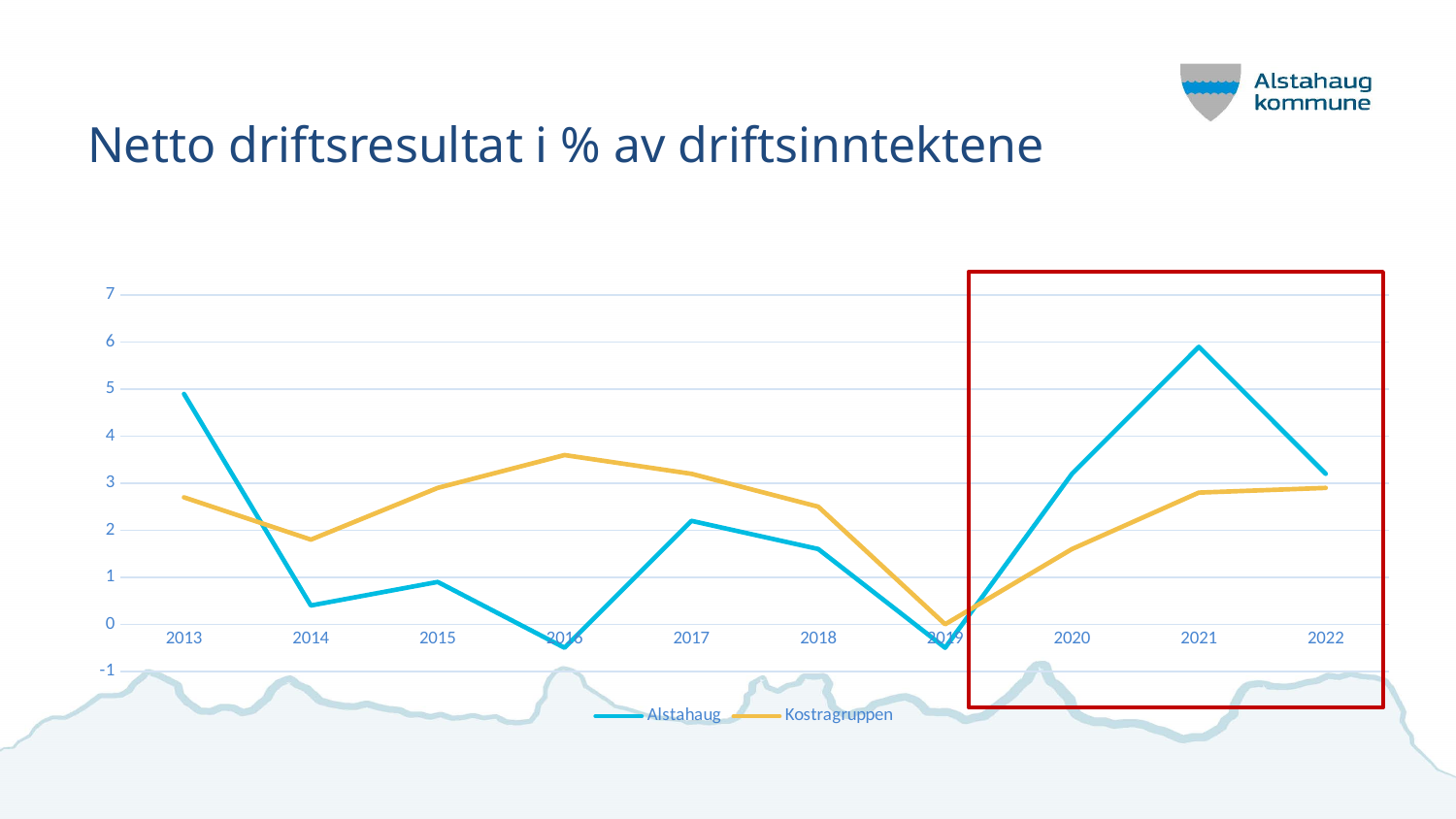
In which year does the Kostragruppen series reach its highest value? 2016 Is the value for Alstahaug in 2014 greater or less than 1? less Which series has the higher value in 2016, Alstahaug or Kostragruppen? Kostragruppen How many years are shown on the x axis? 10 Which series has the higher value in 2013, Alstahaug or Kostragruppen? Alstahaug Is the value for Alstahaug in 2021 greater or less than 5? greater What is the title of the chart? Netto driftsresultat i % av driftsinntektene What kind of chart is shown on the slide? line chart In which year does the Kostragruppen series reach its lowest value? 2019 How many series does the legend list? 2 Is the value for Kostragruppen in 2016 greater or less than 3? greater In which year does the Alstahaug series reach its highest value? 2021